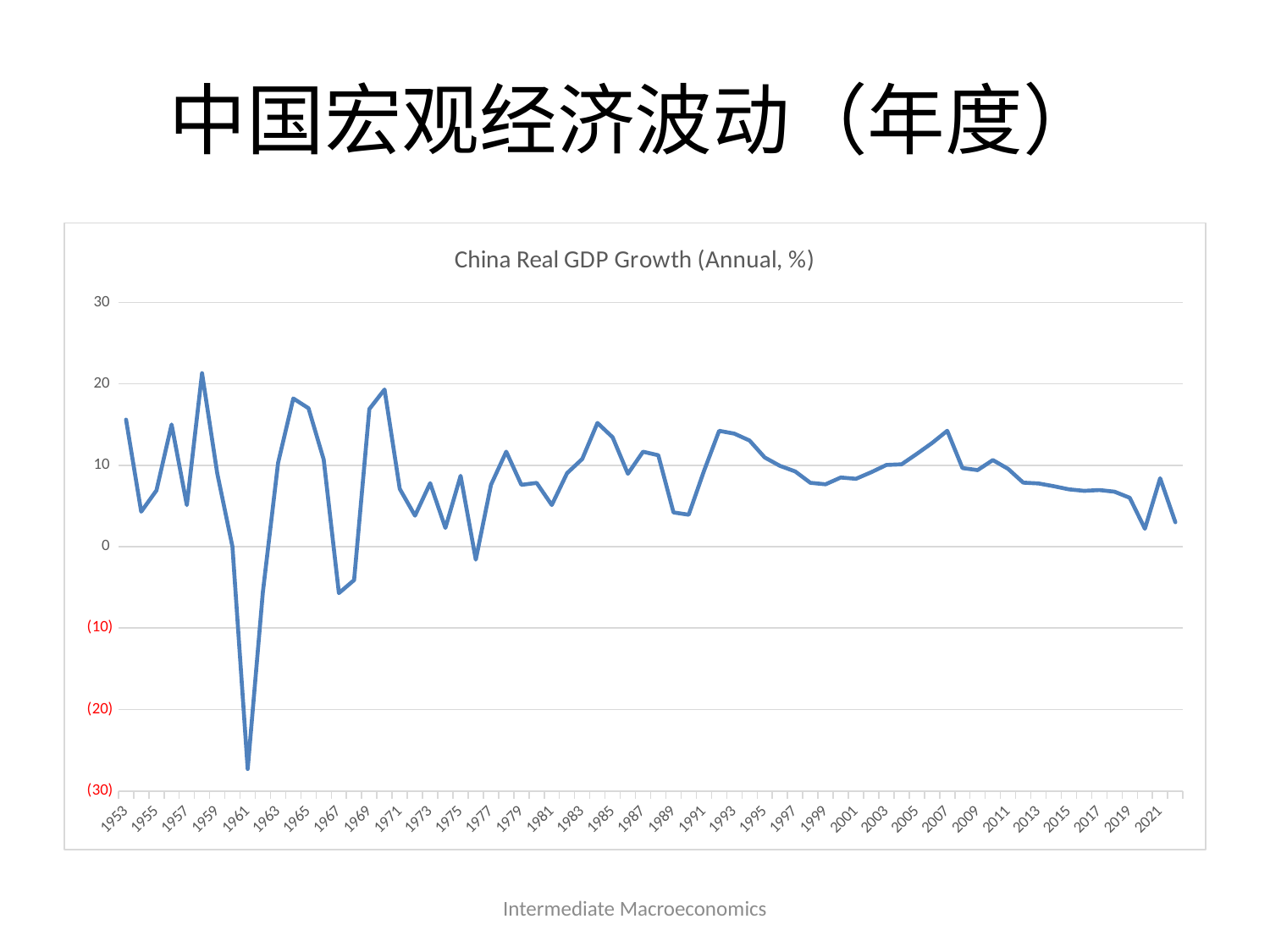
What is the title of the chart? China Real GDP Growth (Annual, %) Is the value for 1961 greater or less than (20)? less Is the value for 1967 greater or less than 0? less In which year does the line reach its lowest value? 1961 Is the value for 2020 greater or less than 10? less What kind of chart is shown on the slide? line chart In which year does the line reach its highest value? 1958 Do the values generally rise or fall from 2007 to 2019? fall Which year has the higher value, 1958 or 1961? 1958